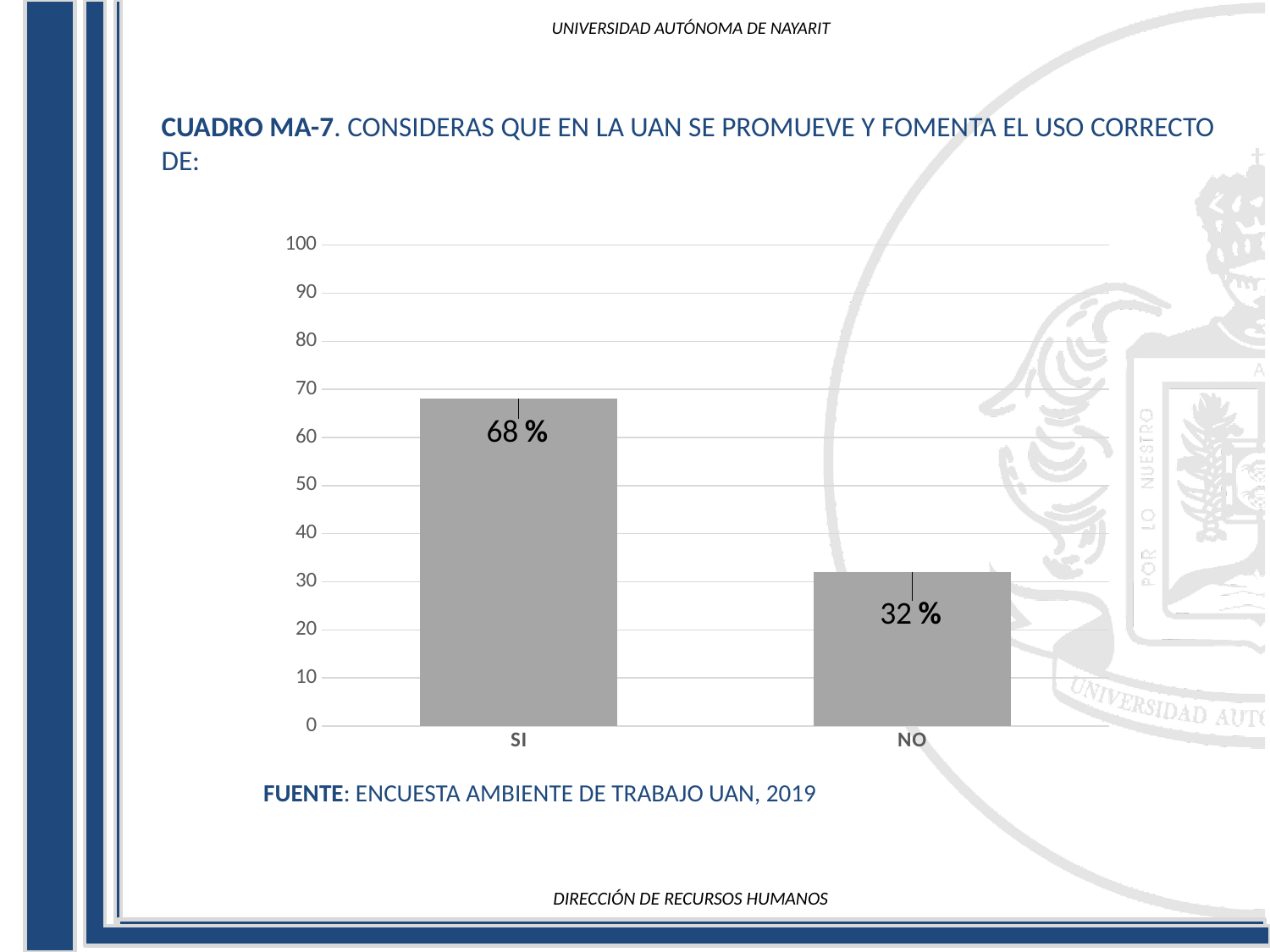
What is the difference between the values for SI and NO? 36 % How many categories are shown on the x axis? 2 What is the value for SI? 68 % What is the highest value shown on the vertical axis? 100 Which is larger, the value for SI or the value for NO? SI What source is cited below the chart? ENCUESTA AMBIENTE DE TRABAJO UAN, 2019 Is the value for NO greater or less than 40? less Which category has the highest value? SI What is the value for NO? 32 % Is the value for SI greater or less than 60? greater Which category has the lowest value? NO What kind of chart is shown on the slide? bar chart